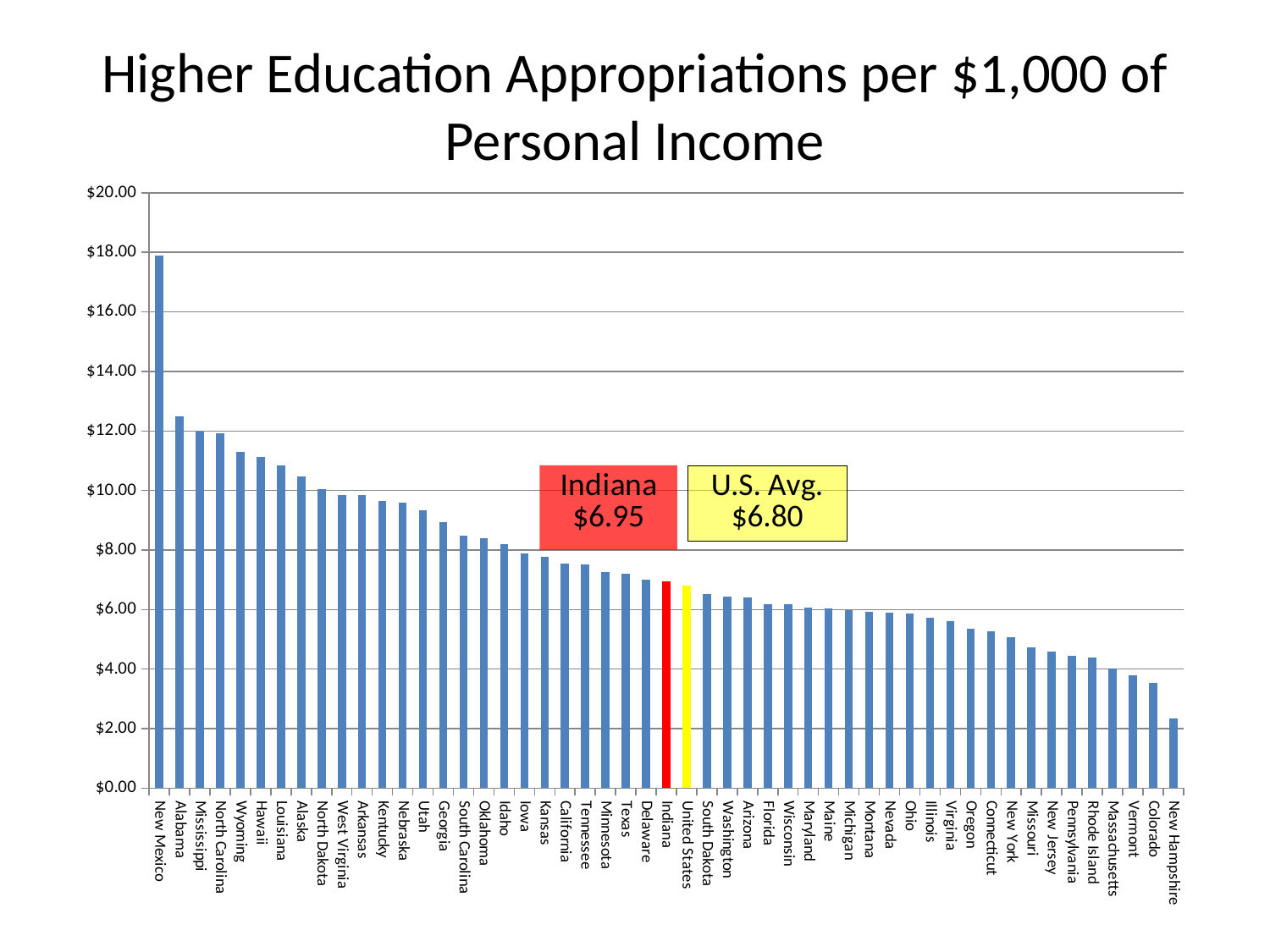
What colour is the bar for Indiana? red Do the values rise or fall moving from left to right along the x axis? fall Which state has the lowest higher education appropriations per $1,000 of personal income? New Hampshire Is the value for Colorado greater or less than $4.00? less What is the difference between the Indiana value and the U.S. average? $0.15 Is the value for Hawaii greater or less than $10.00? greater What is the value for Indiana? $6.95 What is the value for the U.S. average (United States)? $6.80 Is the value for New Mexico greater or less than $16.00? greater Which is larger, the value for Indiana or the value for the United States? Indiana What kind of chart is shown on the slide? bar chart Which state has the highest higher education appropriations per $1,000 of personal income? New Mexico